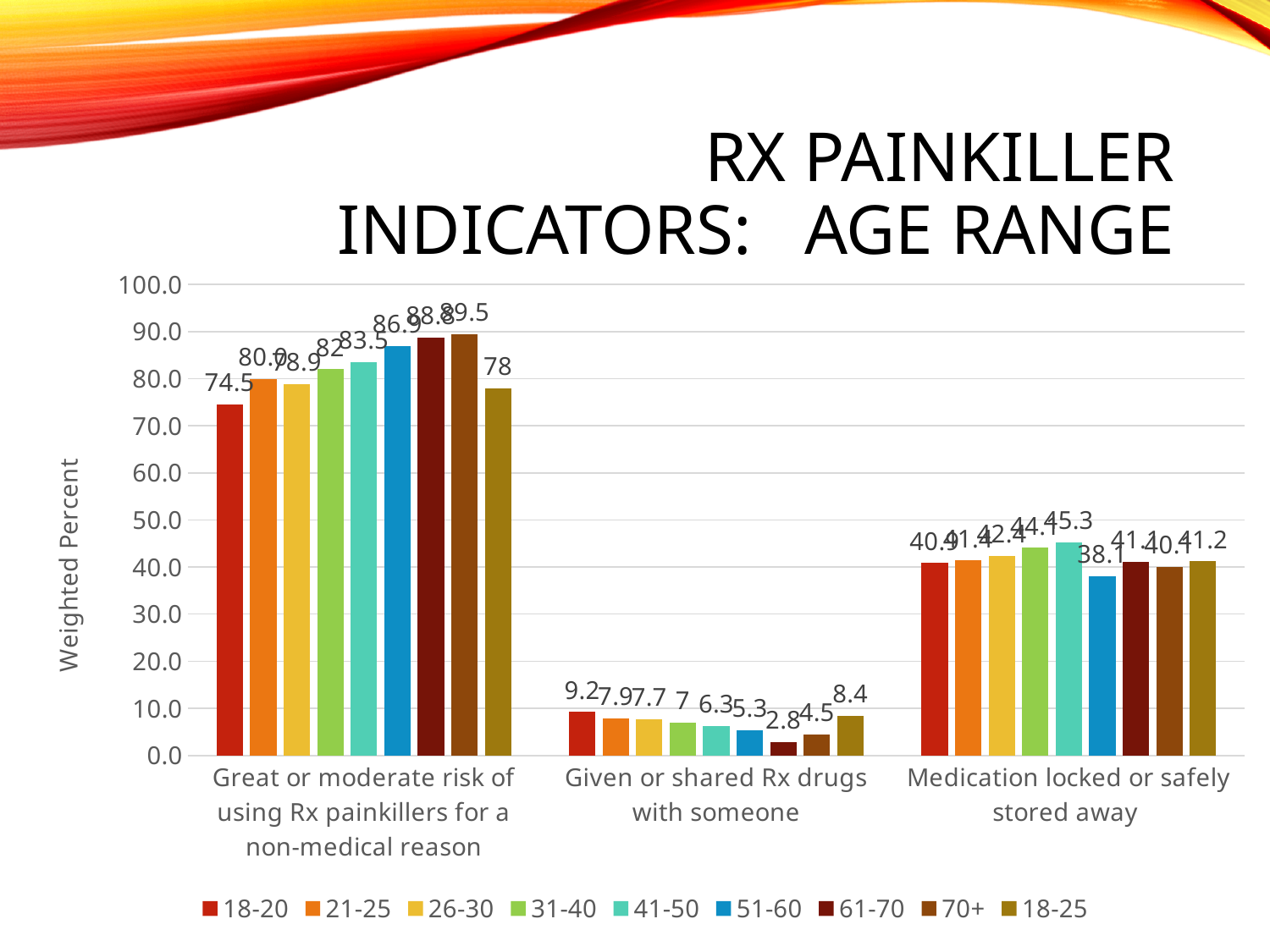
What is the title of the y axis? Weighted Percent What is the value for the 18-20 age group for 'Great or moderate risk of using Rx painkillers for a non-medical reason'? 74.5 How many categories are shown along the x axis? 3 What is the value for the 61-70 age group for 'Given or shared Rx drugs with someone'? 2.8 What is the value for the 51-60 age group for 'Medication locked or safely stored away'? 38.1 Which age group has the lowest value for 'Great or moderate risk of using Rx painkillers for a non-medical reason'? 18-20 What kind of chart is shown on the slide? bar chart What is the difference between the 18-20 and 61-70 values for 'Given or shared Rx drugs with someone'? 6.4 Which age group has the highest value for 'Given or shared Rx drugs with someone'? 18-20 What is the value for the 18-25 age group for 'Great or moderate risk of using Rx painkillers for a non-medical reason'? 78 For 'Great or moderate risk of using Rx painkillers for a non-medical reason', which is larger: the 18-20 value or the 18-25 value? 18-25 How many age-range series does the legend list? 9